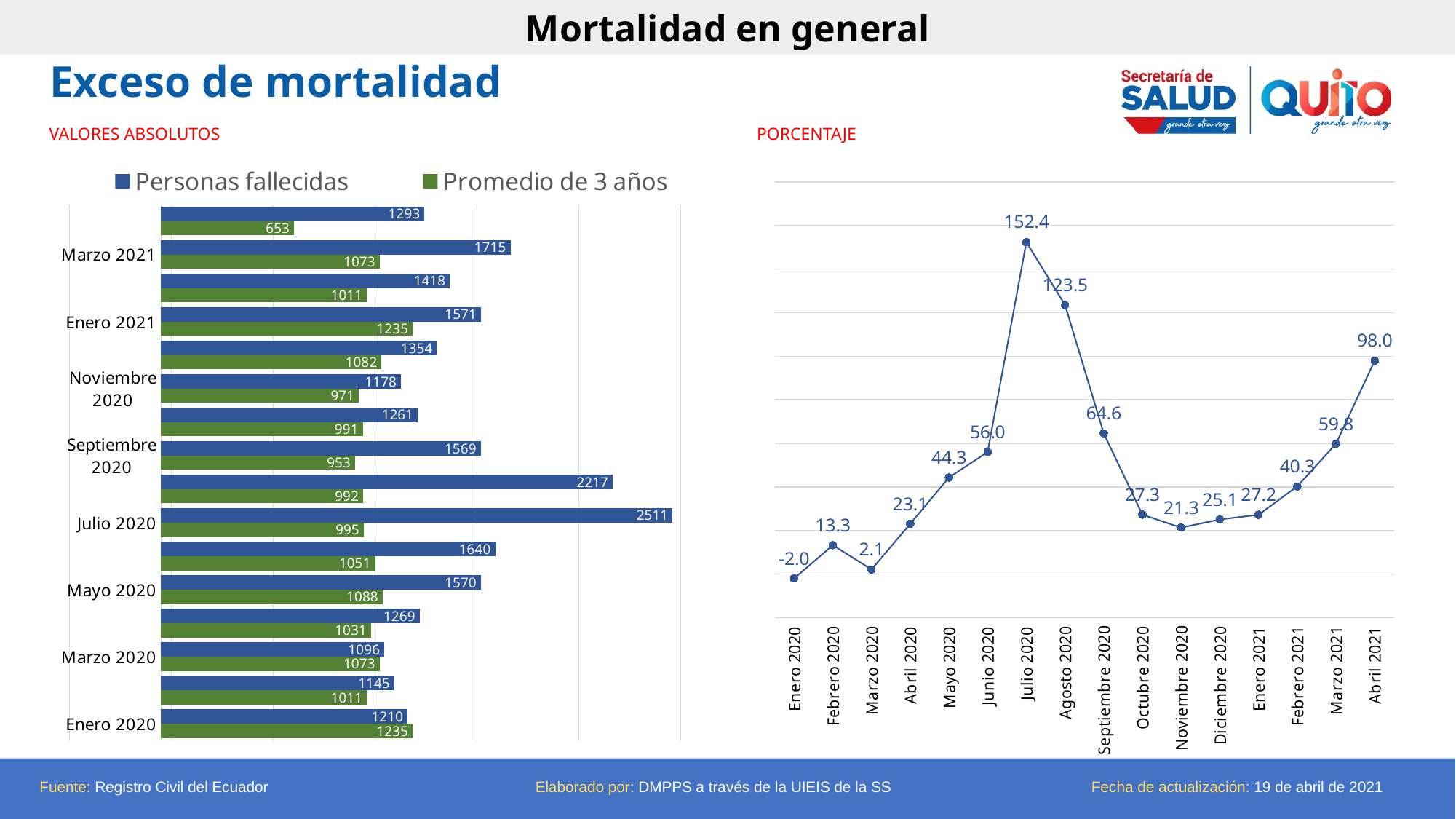
In the VALORES ABSOLUTOS bar chart, what is the value of Personas fallecidas for Julio 2020? 2511 In the PORCENTAJE line chart, what is the value for Julio 2020? 152.4 In the PORCENTAJE line chart, what is the difference between the values for Agosto 2020 and Septiembre 2020? 58.9 In the VALORES ABSOLUTOS bar chart, what is the difference between Personas fallecidas and Promedio de 3 años for Marzo 2021? 642 In the VALORES ABSOLUTOS bar chart, what is the value of Promedio de 3 años for Enero 2021? 1235 In the PORCENTAJE line chart, do the values rise or fall from Noviembre 2020 to Abril 2021? Rise In the VALORES ABSOLUTOS bar chart, which is larger for Enero 2020: Personas fallecidas or Promedio de 3 años? Promedio de 3 años In the VALORES ABSOLUTOS bar chart, which labeled month has the highest value for Personas fallecidas? Julio 2020 In the PORCENTAJE line chart, which month has the lowest value? Enero 2020 How many series does the legend of the VALORES ABSOLUTOS chart list? 2 What kind of chart is the VALORES ABSOLUTOS chart? Bar chart How many months are plotted in the PORCENTAJE line chart? 16